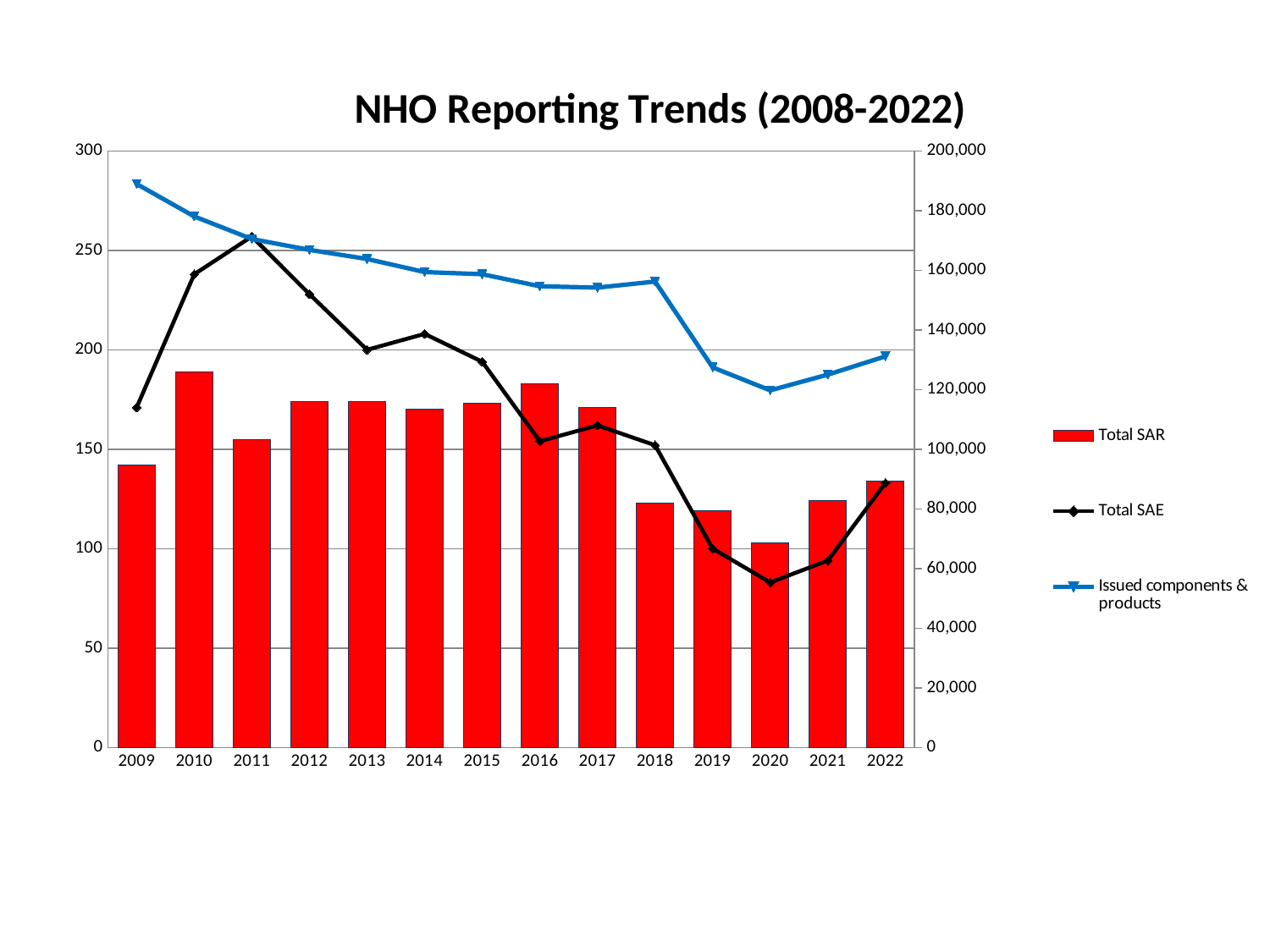
Which is larger, the Total SAR value for 2011 or for 2012? 2012 Which year has the highest Total SAE value? 2011 What kind of chart is shown on the slide? A combined bar and line chart Which year has the lowest Total SAR value? 2020 Which year has the highest value for Issued components & products? 2009 How many series does the legend list? 3 How many years are shown on the x axis? 14 Does the Issued components & products line generally rise or fall from 2009 to 2020? fall Is the Issued components & products value for 2009 greater or less than 180,000? greater Is the Total SAR value for 2009 greater or less than 150? less Is the Total SAE value for 2020 greater or less than 100? less What is the title of the chart? NHO Reporting Trends (2008-2022)